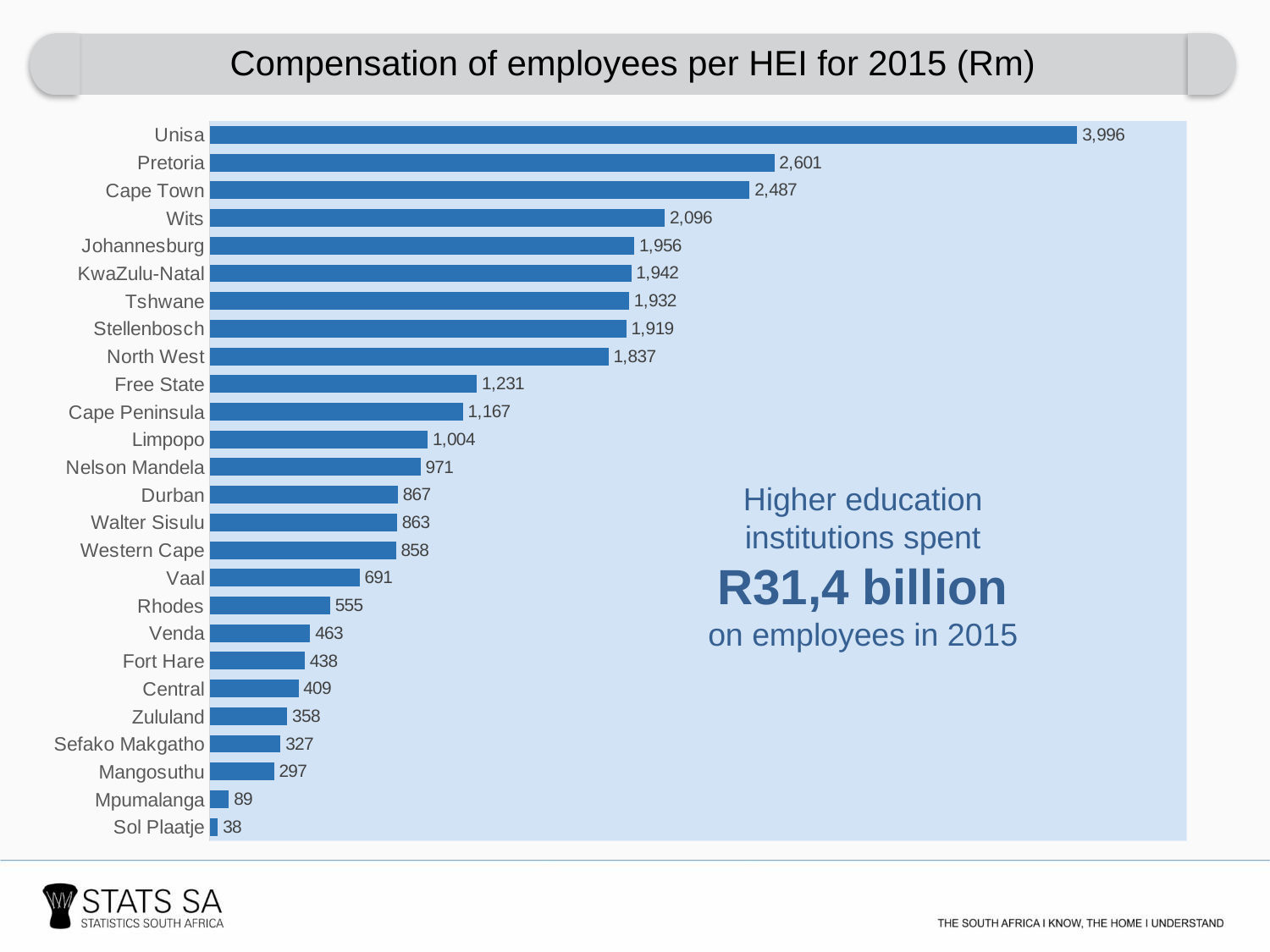
What type of chart is shown on the slide? Bar chart What is the value for Sefako Makgatho? 327 What value is shown for Stellenbosch? 1,919 What is the compensation of employees for Unisa? 3,996 How many institutions are shown in the chart? 26 Which institution has the highest compensation of employees? Unisa Which institution has the lowest compensation of employees? Sol Plaatje Which has a larger value, Rhodes or Vaal? Vaal What is the difference between the values for Unisa and Pretoria? 1,395 According to the text on the chart, how much did higher education institutions spend on employees in 2015? R31,4 billion Which has a larger value, Free State or Cape Peninsula? Free State What is the difference between the values for Wits and Johannesburg? 140